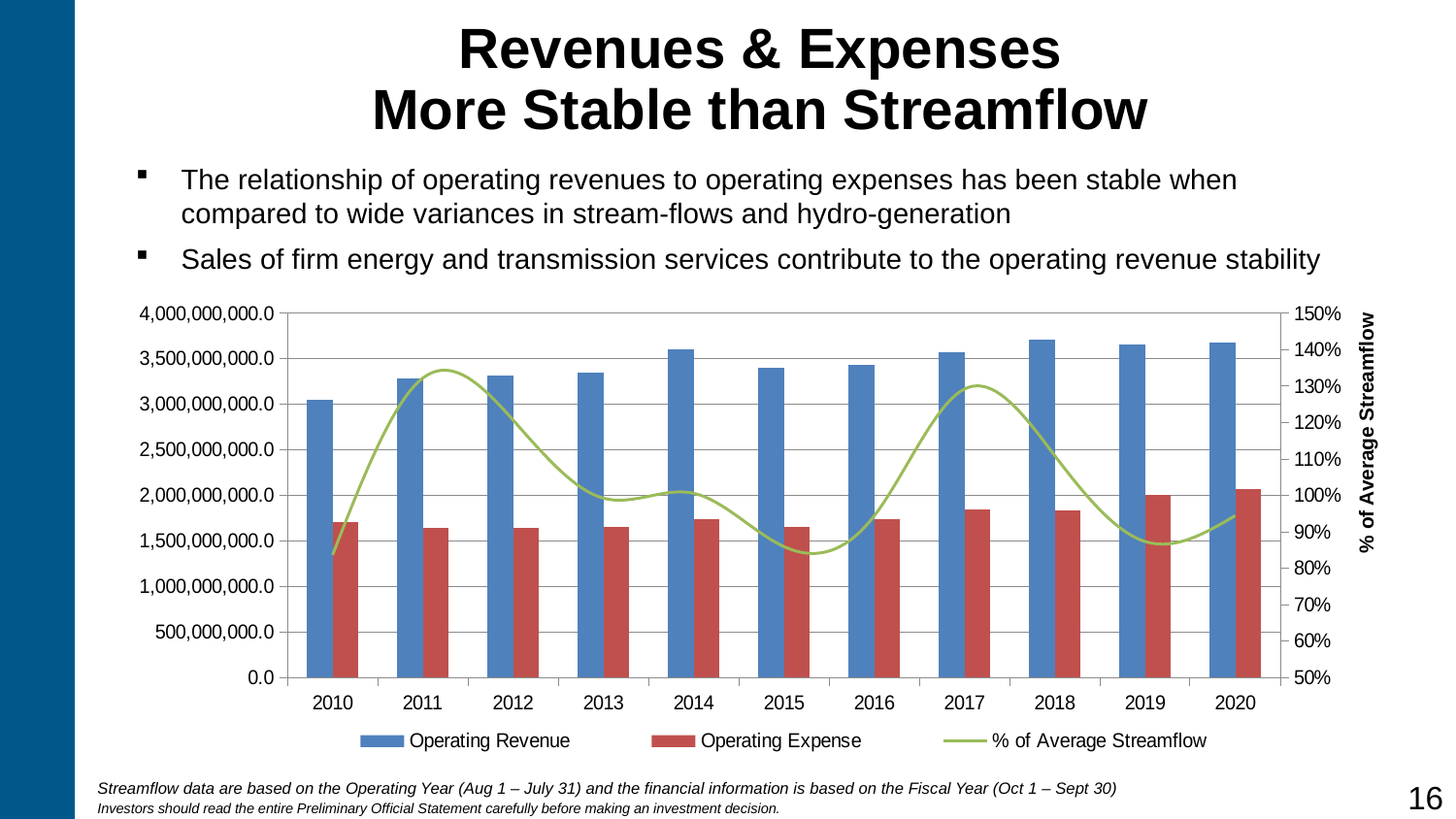
Which is larger, the Operating Revenue for 2010 or for 2018? 2018 Is the Operating Expense for 2010 greater or less than 2,000,000,000.0? less Is the % of Average Streamflow for 2011 greater or less than 130%? greater Which year has the lowest Operating Revenue? 2010 How many series does the legend list? 3 What kind of chart is shown on the slide? A bar chart combined with a line How many years are shown along the x axis? 11 What is the title of the right-hand vertical axis? % of Average Streamflow Which year has the highest Operating Expense? 2020 Is the % of Average Streamflow for 2015 greater or less than 90%? less Does the Operating Revenue rise or fall from 2010 to 2014? rise